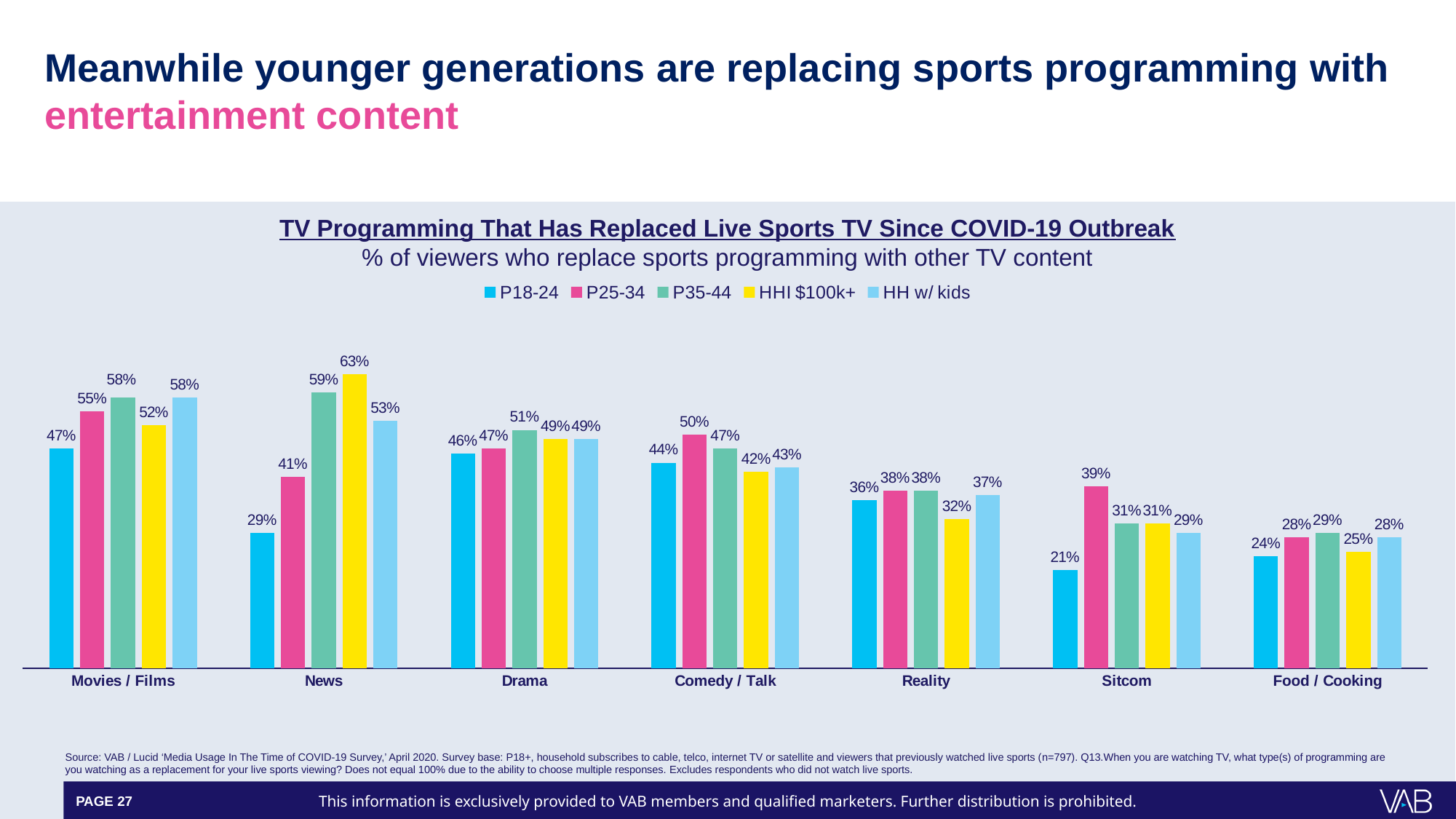
What is the value for HHI $100k+ in the Movies / Films category? 52% Do the P25-34 values generally rise or fall from Movies / Films to Food / Cooking? Fall How many programming categories are shown on the x axis? 7 What is the title of the chart? TV Programming That Has Replaced Live Sports TV Since COVID-19 Outbreak What kind of chart is shown on the slide? Bar chart Which is larger for Comedy / Talk: the P25-34 value or the P35-44 value? P25-34 What is the value for HH w/ kids in the Sitcom category? 29% What is the difference between the P35-44 and P18-24 values for News? 30 percentage points Which category has the lowest value for the P18-24 series? Sitcom What percentage of P18-24 viewers replaced live sports with News? 29% Which category has the highest value for the HHI $100k+ series? News How many series does the legend list? 5